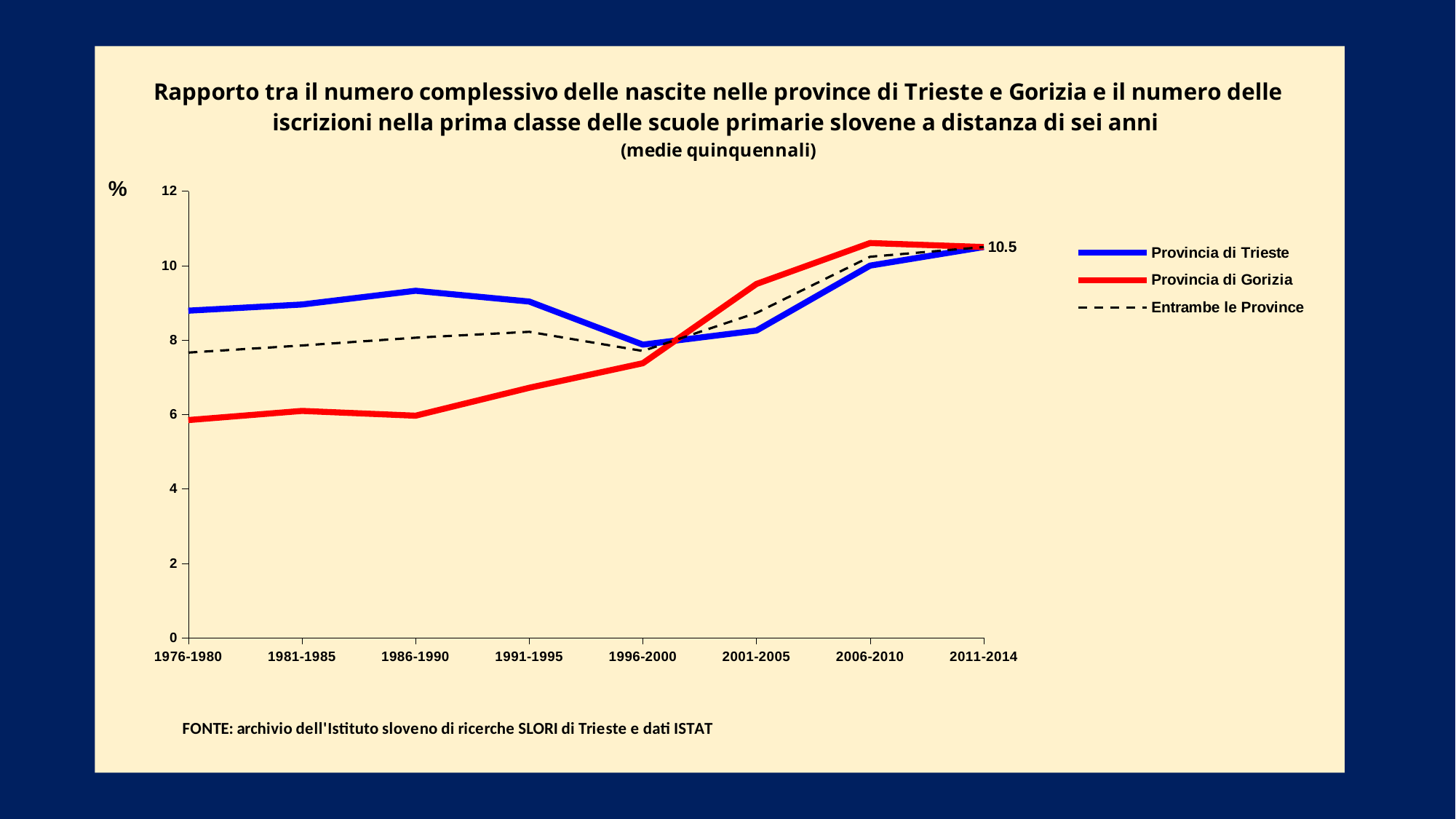
Which series is drawn as a dashed line? Entrambe le Province What kind of chart is shown on the slide? line chart Does the Provincia di Gorizia line generally rise or fall from 1976-1980 to 2011-2014? rise What data label is printed at the 2011-2014 end of the lines? 10.5 In 1976-1980, which is larger: Provincia di Trieste or Provincia di Gorizia? Provincia di Trieste In which period does Provincia di Trieste reach its lowest value? 1996-2000 Is the value for Entrambe le Province in 1976-1980 greater or less than 8? less Is the value for Provincia di Gorizia in 1996-2000 greater or less than 8? less Is the value for Provincia di Trieste in 1986-1990 greater or less than 8? greater How many series does the legend list? 3 How many time periods are shown on the x axis? 8